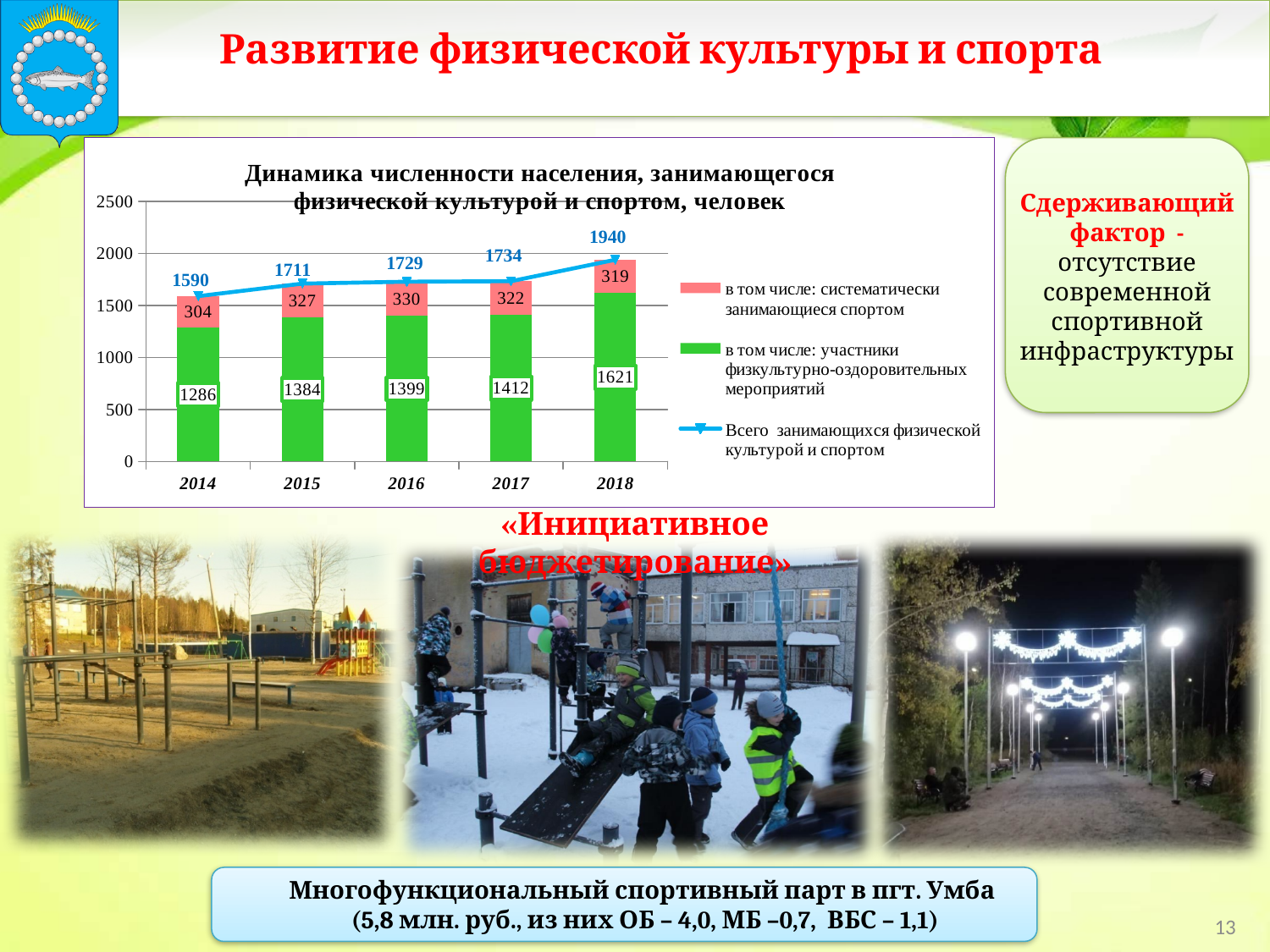
Is the total ('Всего занимающихся') in 2014 greater or less than 1500? greater How many years are shown on the x axis of the chart? 5 What is the difference between the total ('Всего занимающихся') in 2018 and in 2017? 206 How many series does the chart legend list? 3 Does the total ('Всего занимающихся физической культурой и спортом') rise or fall from 2014 to 2018? rise In which year is 'Всего занимающихся физической культурой и спортом' highest? 2018 What is the value of 'Всего занимающихся физической культурой и спортом' in 2016? 1729 Which is larger: 'в том числе: систематически занимающиеся спортом' in 2016 or in 2018? 2016 What is the value for 'в том числе: систематически занимающиеся спортом' in 2014? 304 What kind of chart is shown on the slide? Stacked bar chart with a line What is the value for 'в том числе: участники физкультурно-оздоровительных мероприятий' in 2018? 1621 In which year is 'в том числе: участники физкультурно-оздоровительных мероприятий' lowest? 2014